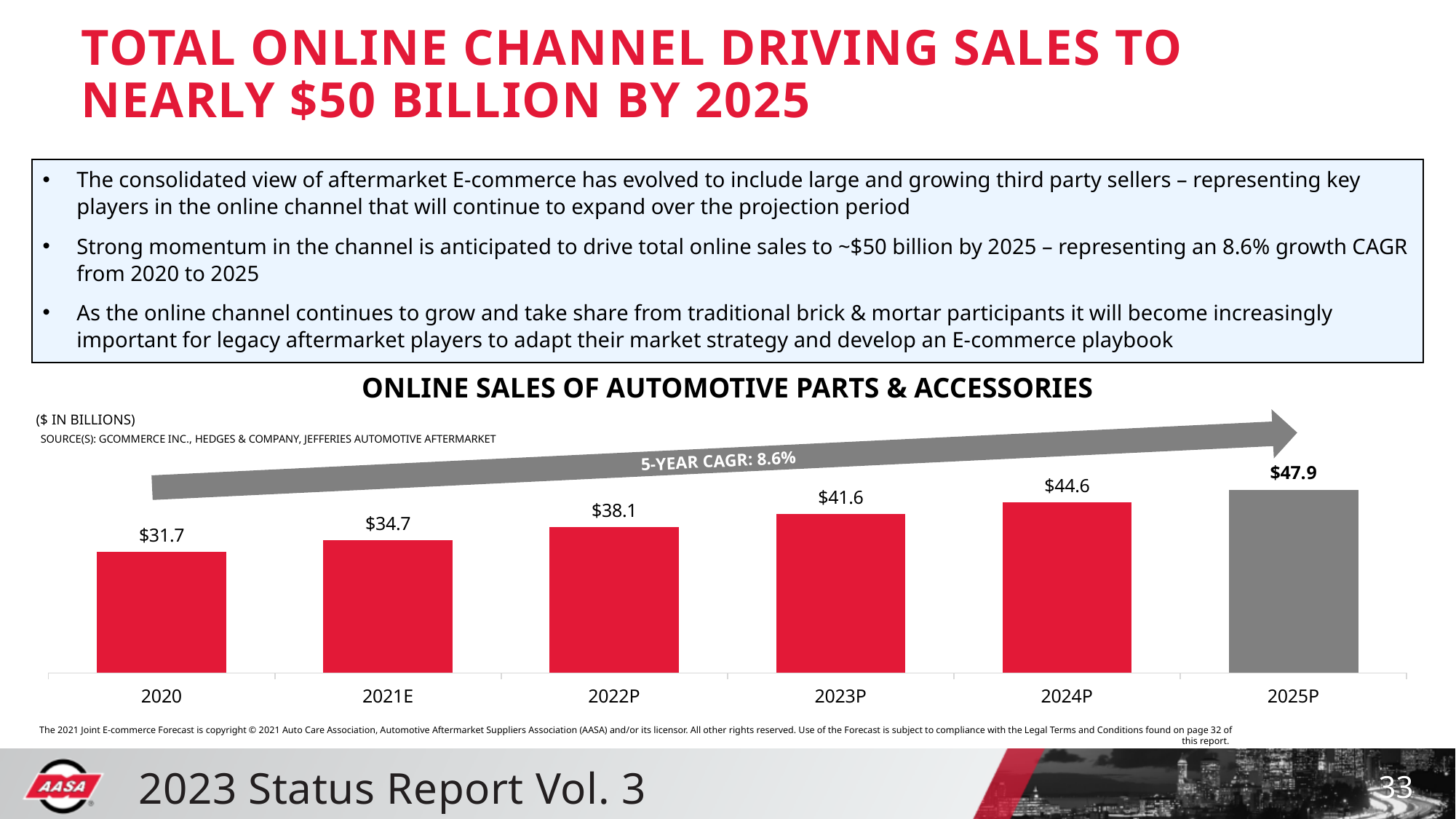
What is the value for 2025P? $47.9 Which is larger, the value for 2024P or the value for 2022P? 2024P How many bars are shown in the chart? 6 What is the value for 2023P? $41.6 Do the values rise or fall from 2020 to 2025P? Rise What 5-year CAGR is shown on the arrow above the bars? 8.6% What is the difference between the values for 2025P and 2020? $16.2 What kind of chart is shown? Bar chart What is the difference between the values for 2022P and 2021E? $3.4 Which year has the lowest value? 2020 Which year has the highest value? 2025P What is the value for 2020? $31.7